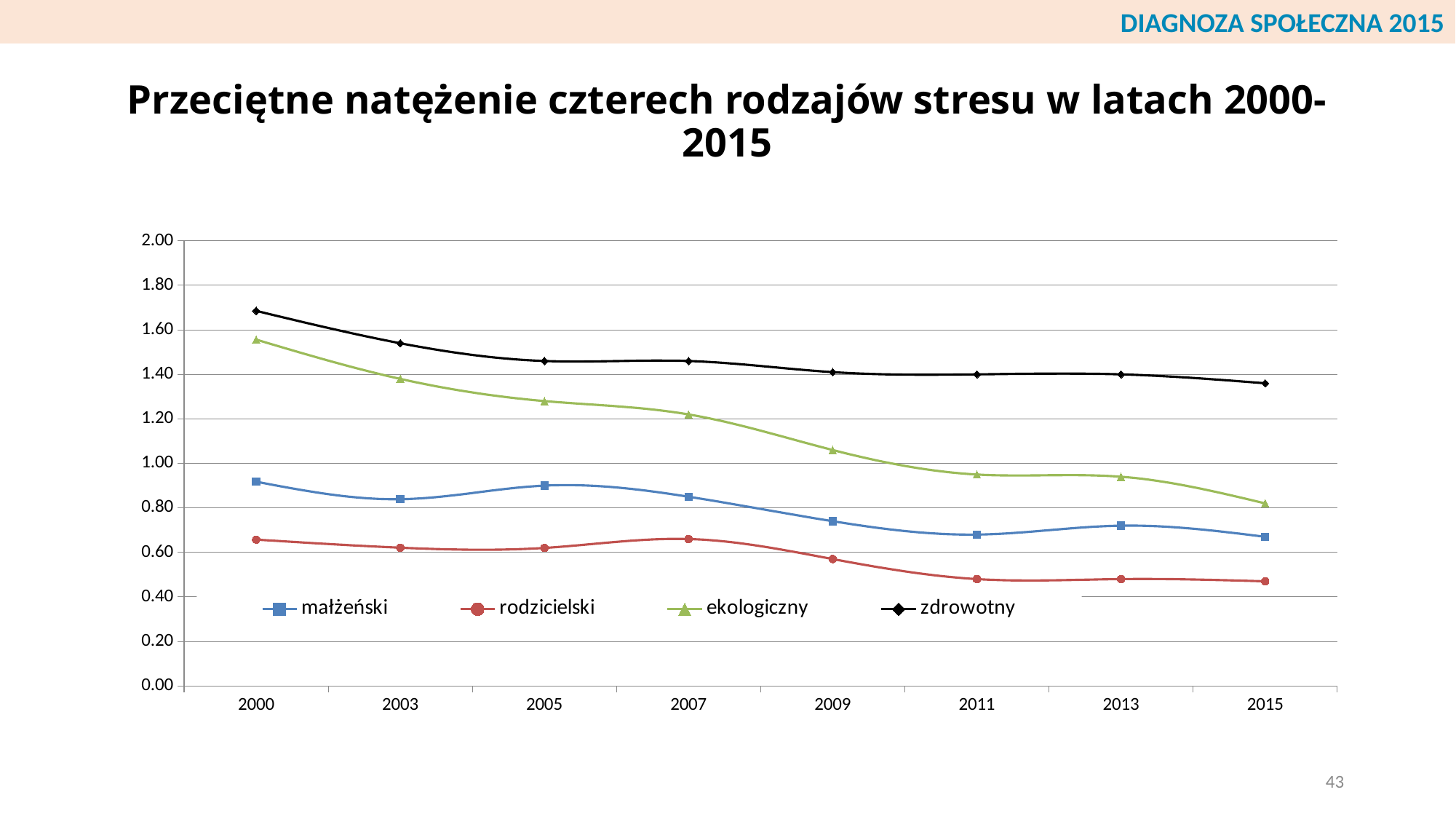
Which series has the highest value in 2000? zdrowotny Is the value for rodzicielski in 2011 greater or less than 0.60? less How many series does the legend list? 4 What kind of chart is shown on the slide? line chart In 2007, which is larger: the value for ekologiczny or the value for małżeński? ekologiczny Is the value for ekologiczny in 2000 greater or less than 1.40? greater Which series has the lowest value in 2015? rodzicielski How many years are plotted along the x axis? 8 Is the value for zdrowotny in 2000 greater or less than 1.60? greater Does the zdrowotny series rise or fall from 2000 to 2015? fall